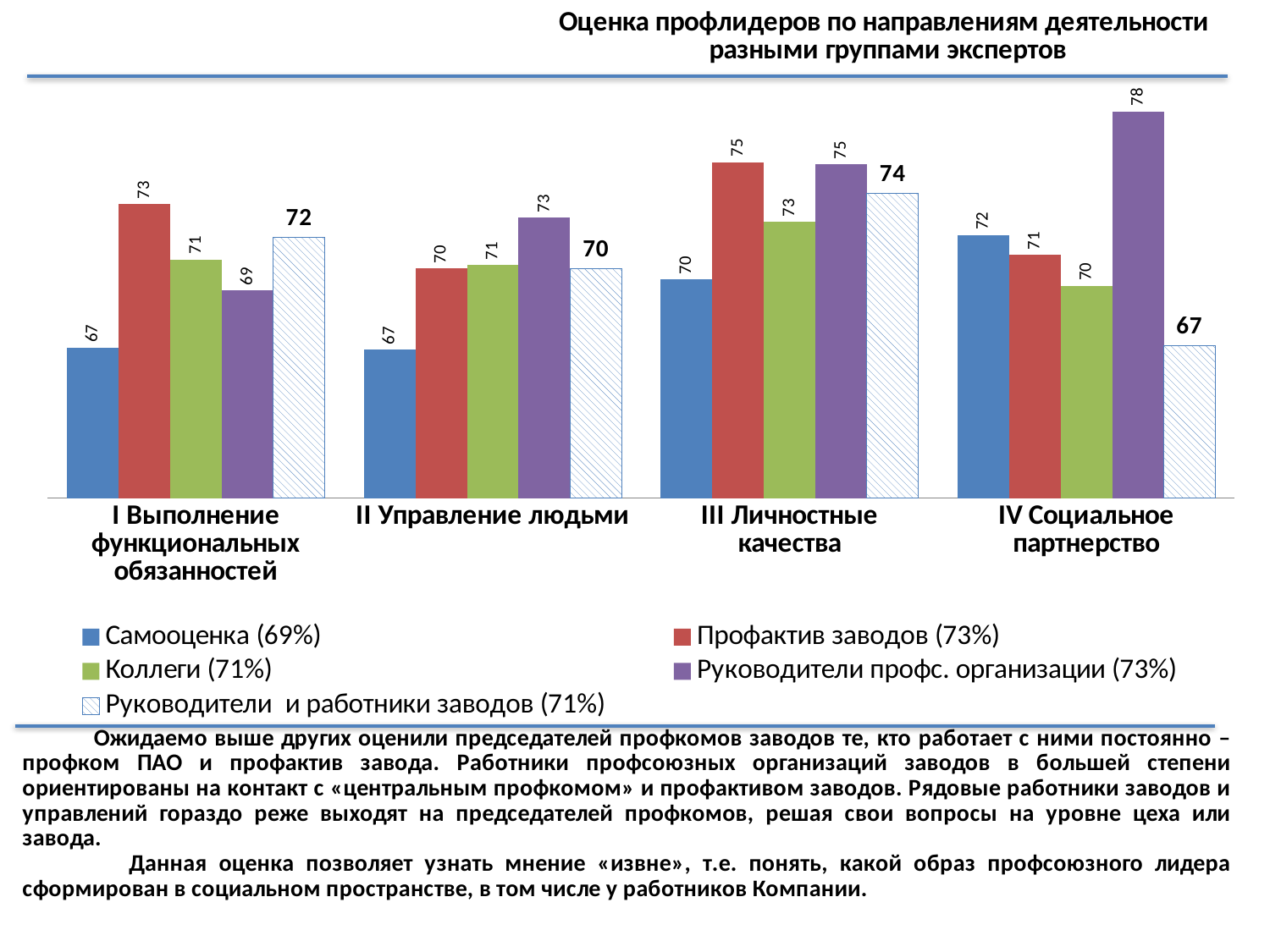
What is the value for Самооценка in the category I Выполнение функциональных обязанностей? 67 How many series does the chart legend list? 5 What is the difference between the Профактив заводов value and the Самооценка value in the category III Личностные качества? 5 Which series has the lowest value in the category I Выполнение функциональных обязанностей? Самооценка What type of chart is shown on the slide? bar chart What is the value for Коллеги in the category II Управление людьми? 71 Which series has the highest value in the category IV Социальное партнерство? Руководители профс. организации In the category II Управление людьми, which is larger: the value for Руководители профс. организации or the value for Профактив заводов? Руководители профс. организации What is the value for Руководители и работники заводов in the category III Личностные качества? 74 How many categories are shown on the x axis of the chart? 4 What percentage is shown in the legend next to Профактив заводов? 73% What is the value for Руководители профс. организации in the category IV Социальное партнерство? 78